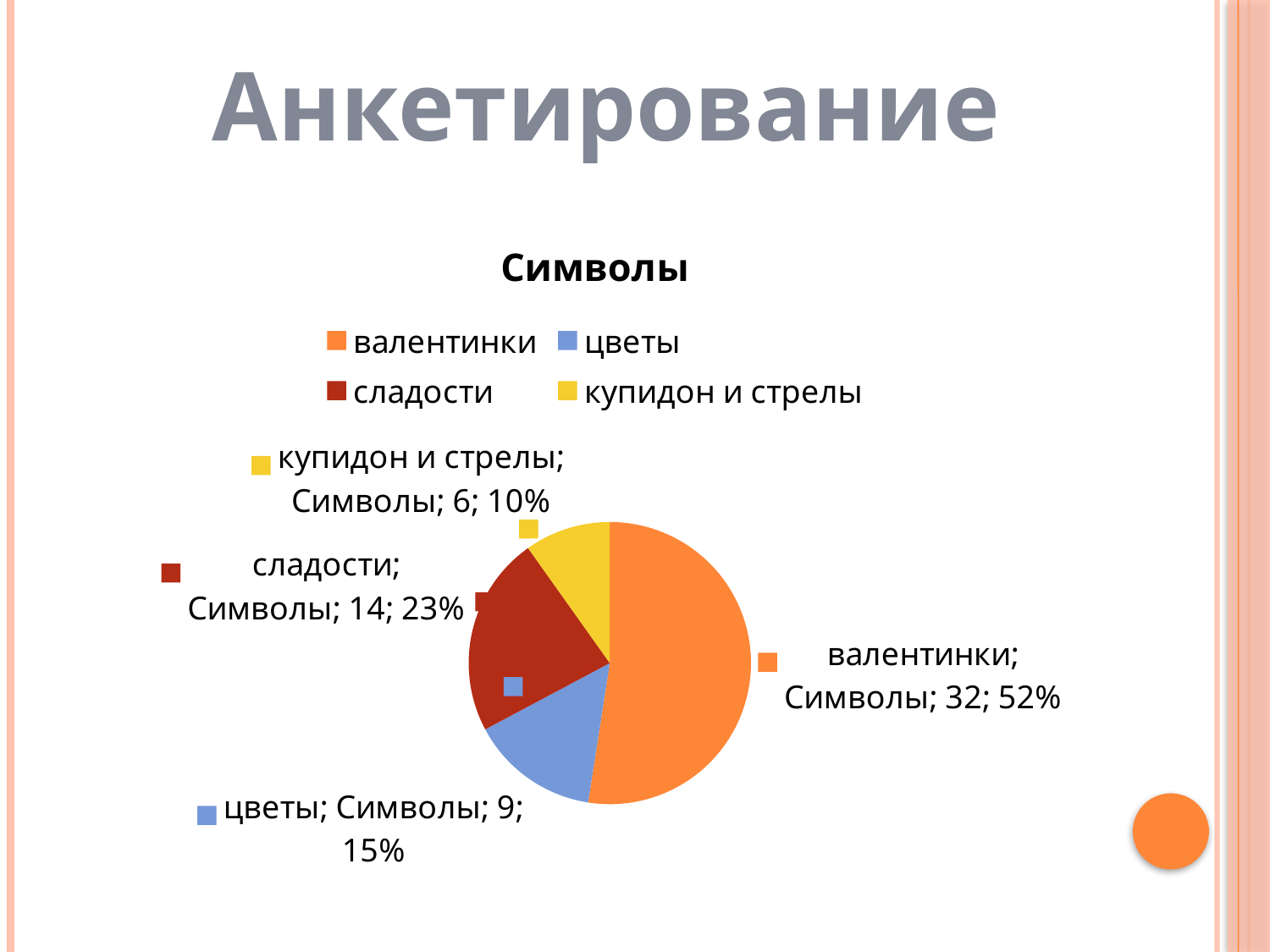
How many slices does the pie chart have? 4 What is the value for валентинки? 32 What is the title of the chart? Символы What type of chart is shown on the slide? pie chart Which category has the largest slice? валентинки What is the value for сладости? 14 What is the difference between the values for валентинки and сладости? 18 Which is larger, the value for цветы or the value for сладости? сладости How many entries does the legend list? 4 Which category has the smallest slice? купидон и стрелы What is the value for цветы? 9 What percentage share does купидон и стрелы have? 10%